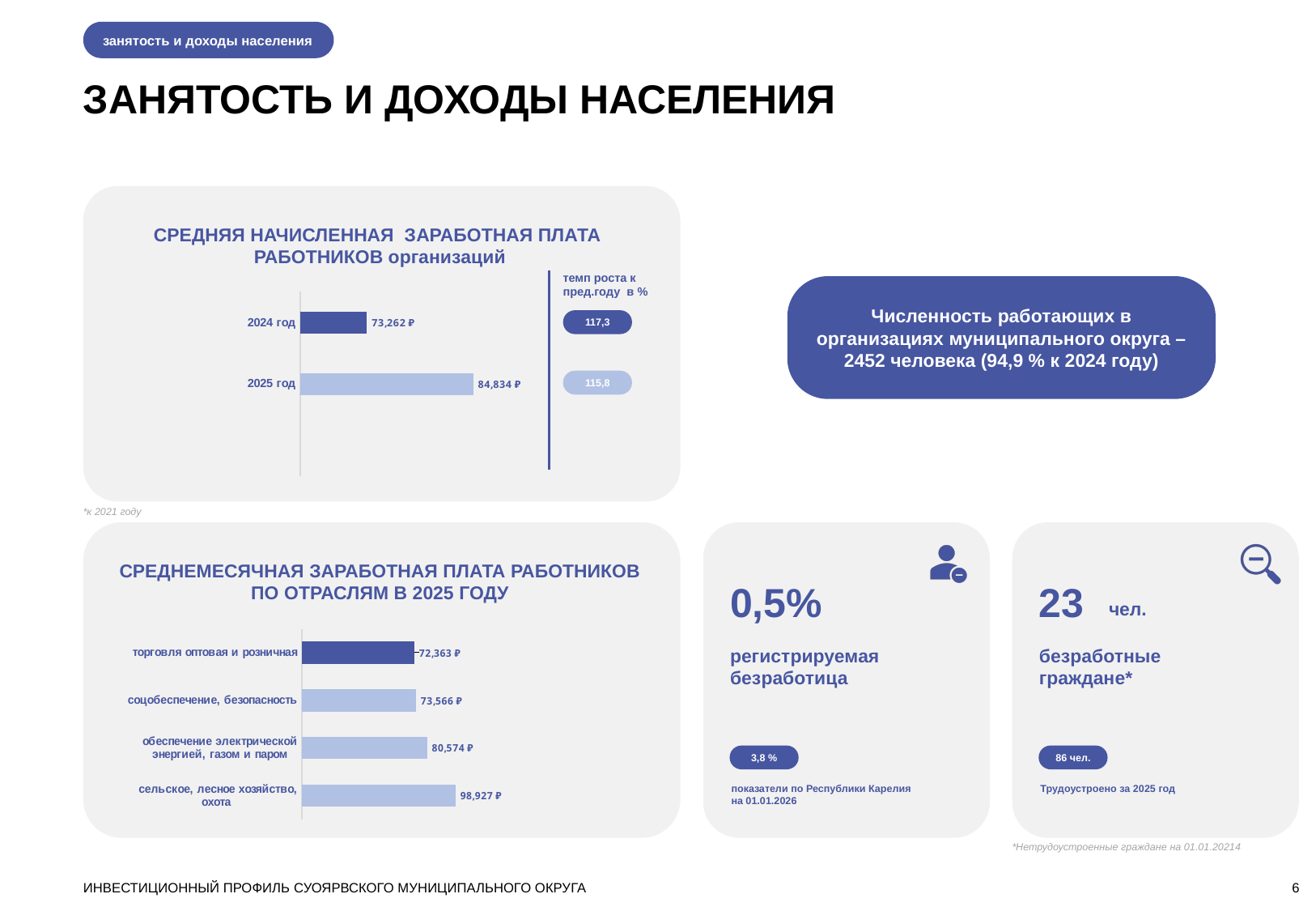
In the chart 'СРЕДНЕМЕСЯЧНАЯ ЗАРАБОТНАЯ ПЛАТА РАБОТНИКОВ ПО ОТРАСЛЯМ В 2025 ГОДУ', what is the value for 'обеспечение электрической энергией, газом и паром'? 80,574 ₽ How many categories are shown in the chart 'СРЕДНЕМЕСЯЧНАЯ ЗАРАБОТНАЯ ПЛАТА РАБОТНИКОВ ПО ОТРАСЛЯМ В 2025 ГОДУ'? 4 In the chart 'СРЕДНЕМЕСЯЧНАЯ ЗАРАБОТНАЯ ПЛАТА РАБОТНИКОВ ПО ОТРАСЛЯМ В 2025 ГОДУ', what is the difference between 'сельское, лесное хозяйство, охота' and 'торговля оптовая и розничная'? 26,564 ₽ In the chart 'СРЕДНЯЯ НАЧИСЛЕННАЯ ЗАРАБОТНАЯ ПЛАТА РАБОТНИКОВ организаций', what is the growth rate (темп роста к пред.году в %) shown for 2024 год? 117,3 In the chart 'СРЕДНЕМЕСЯЧНАЯ ЗАРАБОТНАЯ ПЛАТА РАБОТНИКОВ ПО ОТРАСЛЯМ В 2025 ГОДУ', which category has the lowest value? торговля оптовая и розничная In the chart 'СРЕДНЯЯ НАЧИСЛЕННАЯ ЗАРАБОТНАЯ ПЛАТА РАБОТНИКОВ организаций', what is the value for 2024 год? 73,262 ₽ In the chart 'СРЕДНЯЯ НАЧИСЛЕННАЯ ЗАРАБОТНАЯ ПЛАТА РАБОТНИКОВ организаций', do the values rise or fall from 2024 год to 2025 год? rise In the chart 'СРЕДНЕМЕСЯЧНАЯ ЗАРАБОТНАЯ ПЛАТА РАБОТНИКОВ ПО ОТРАСЛЯМ В 2025 ГОДУ', which category has the highest value? сельское, лесное хозяйство, охота In the chart 'СРЕДНЕМЕСЯЧНАЯ ЗАРАБОТНАЯ ПЛАТА РАБОТНИКОВ ПО ОТРАСЛЯМ В 2025 ГОДУ', which is larger: 'соцобеспечение, безопасность' or 'обеспечение электрической энергией, газом и паром'? обеспечение электрической энергией, газом и паром What kind of chart is 'СРЕДНЕМЕСЯЧНАЯ ЗАРАБОТНАЯ ПЛАТА РАБОТНИКОВ ПО ОТРАСЛЯМ В 2025 ГОДУ'? bar chart In the chart 'СРЕДНЯЯ НАЧИСЛЕННАЯ ЗАРАБОТНАЯ ПЛАТА РАБОТНИКОВ организаций', by how much does the 2025 год value exceed the 2024 год value? 11,572 ₽ In the chart 'СРЕДНЯЯ НАЧИСЛЕННАЯ ЗАРАБОТНАЯ ПЛАТА РАБОТНИКОВ организаций', what is the value for 2025 год? 84,834 ₽